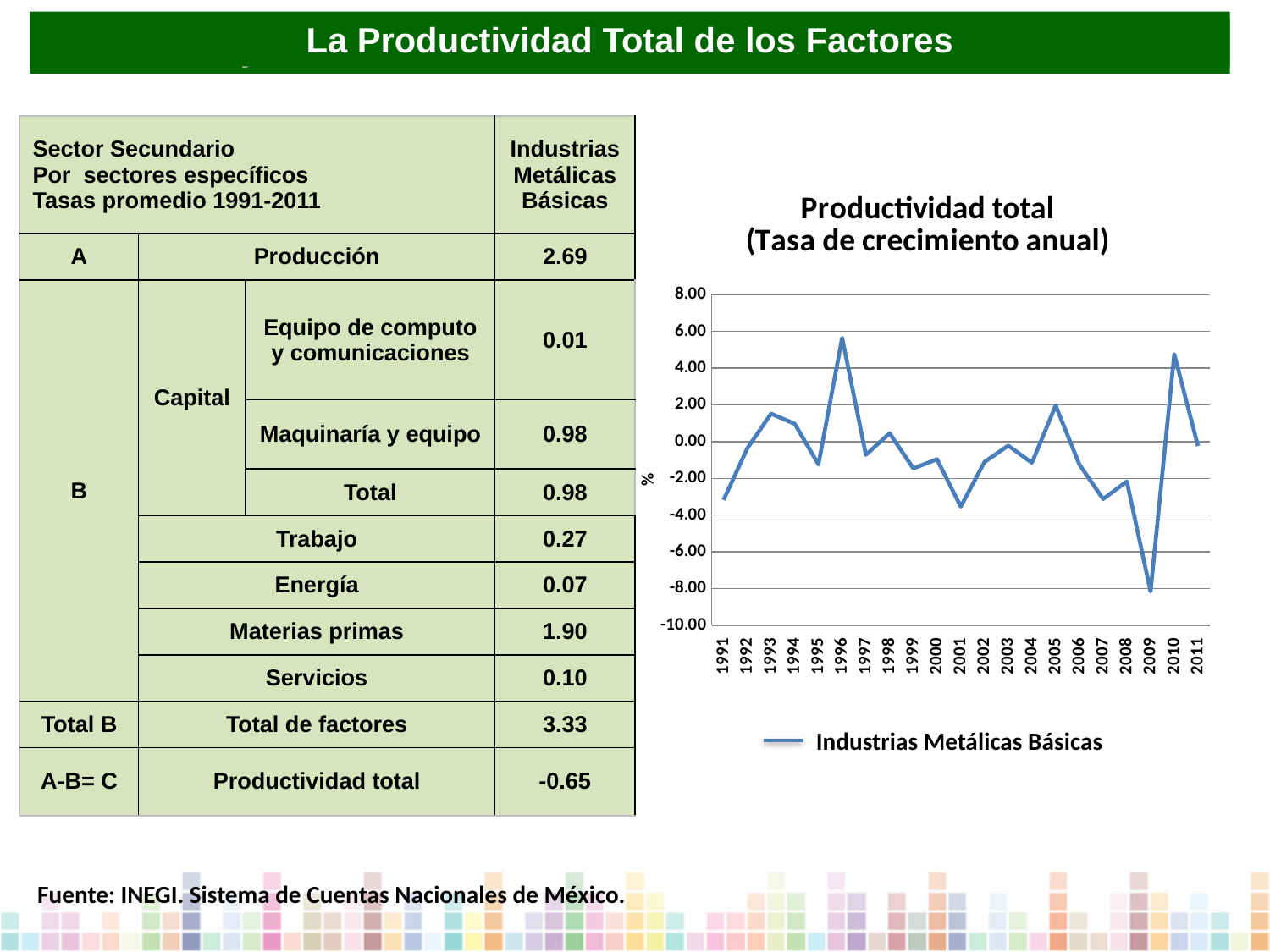
Is the value for 1996 greater or less than 4.00? greater Is the value for 2001 greater or less than -2.00? less How many series does the legend of the chart list? 1 What is the title of the chart? Productividad total (Tasa de crecimiento anual) Is the value for 2009 greater or less than -6.00? less Which year has the larger value, 2005 or 2001? 2005 What kind of chart is shown on the slide? line chart In which year does the line reach its highest value? 1996 What is the name of the series shown in the chart legend? Industrias Metálicas Básicas In which year does the line reach its lowest value? 2009 How many years are plotted along the x axis of the chart? 21